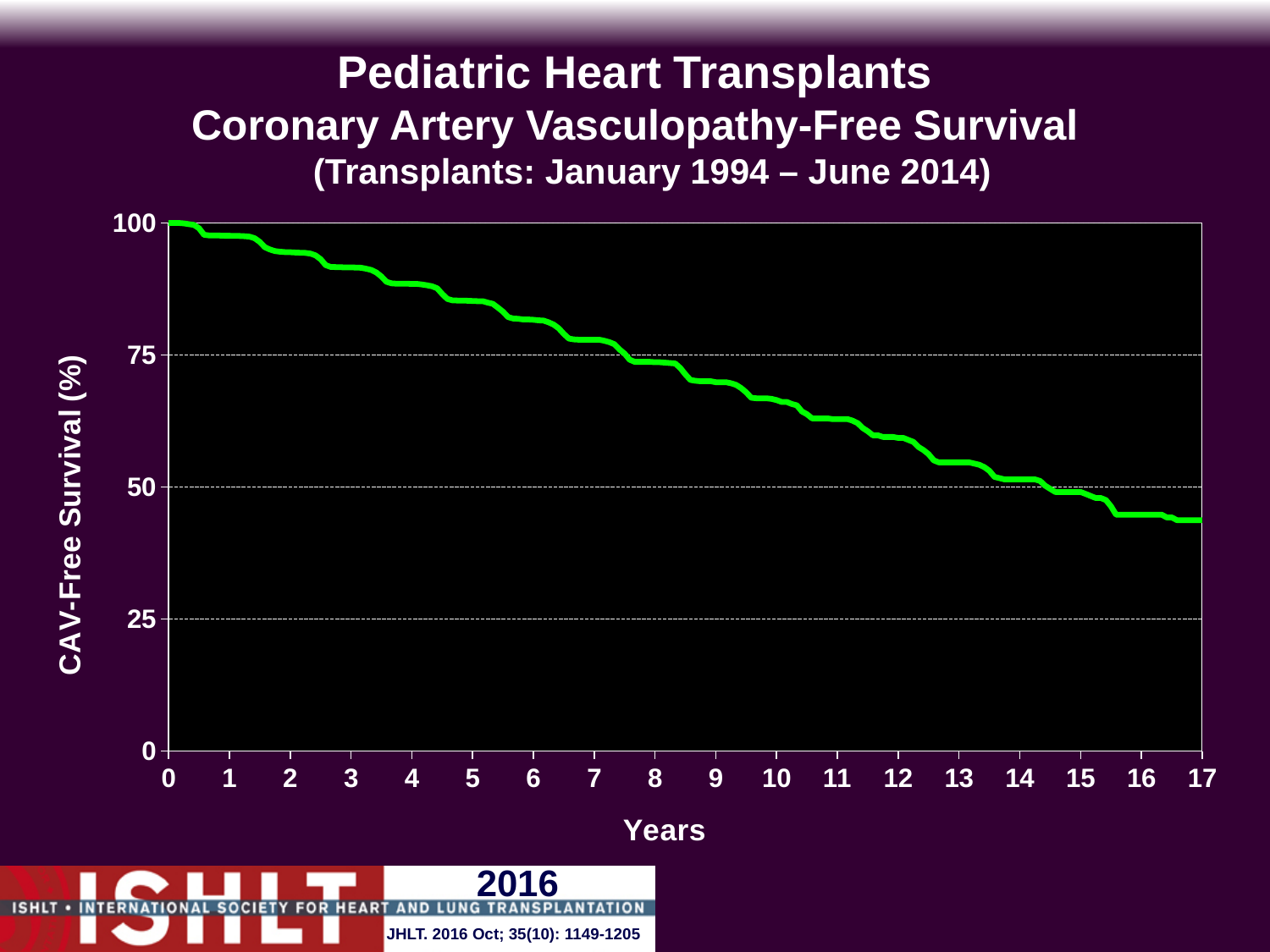
Is the CAV-free survival at year 5 greater or less than 75? greater Is the CAV-free survival at year 16 greater or less than 25? greater Is the CAV-free survival at year 10 greater or less than 50? greater Does CAV-free survival rise or fall as the number of years increases? fall What is the CAV-free survival value at year 0? 100 How many survival curves are plotted on the chart? 1 What is the highest value shown on the x-axis (Years)? 17 What kind of chart is shown on the slide? line chart What is the label of the y-axis? CAV-Free Survival (%)